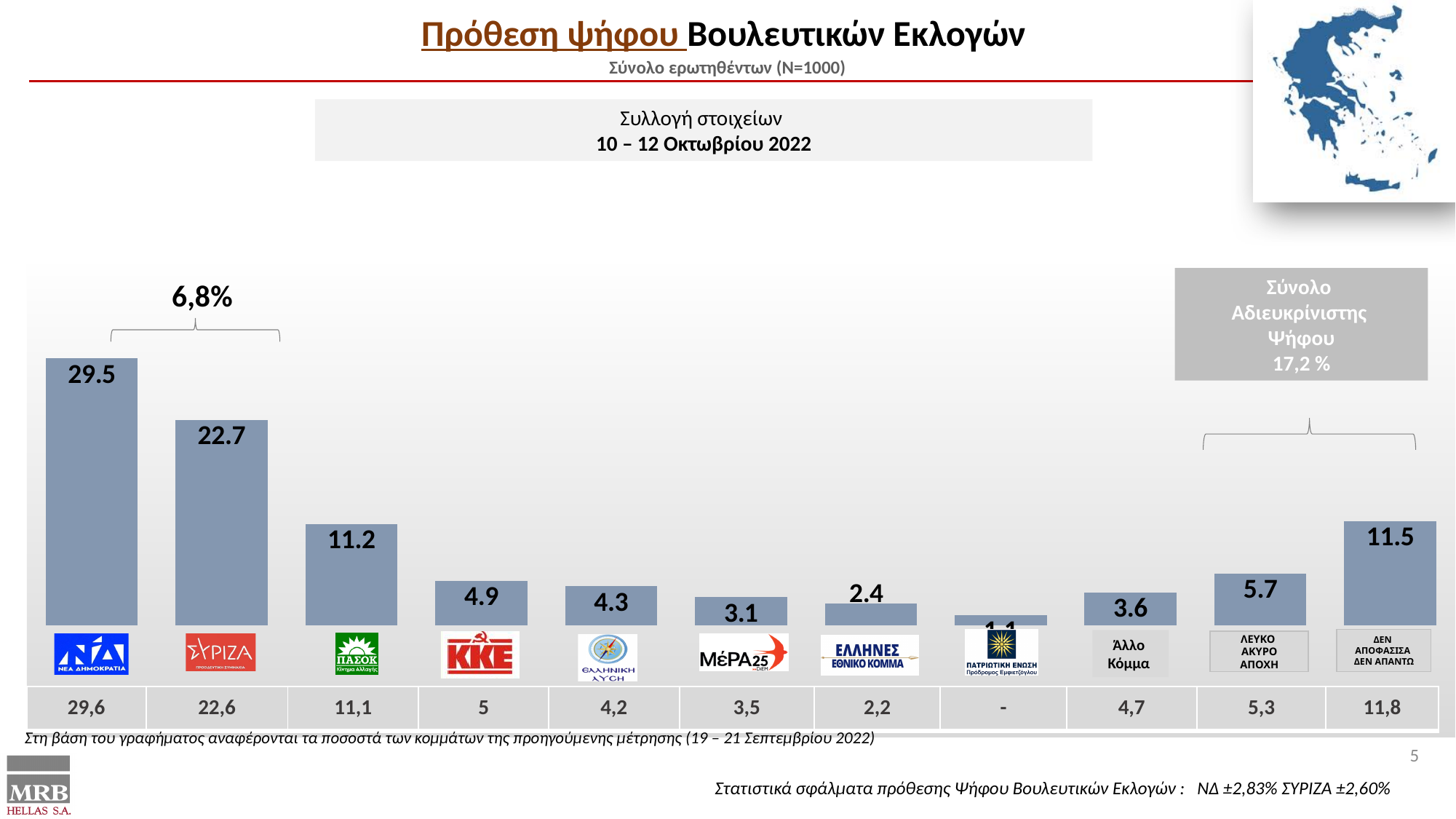
What kind of chart is shown on the slide? bar chart Which category has the highest value? ΝΕΑ ΔΗΜΟΚΡΑΤΙΑ What is the difference between the values for ΠΑΣΟΚ and ΚΚΕ? 6.3 What is the value shown for ΝΕΑ ΔΗΜΟΚΡΑΤΙΑ? 29.5 What is the value shown for ΔΕΝ ΑΠΟΦΑΣΙΣΑ ΔΕΝ ΑΠΑΝΤΩ? 11.5 What is the value shown for ΠΑΣΟΚ? 11.2 What is the value shown for ΚΚΕ? 4.9 How many bars are shown in the chart? 11 What is the difference between the values for ΝΕΑ ΔΗΜΟΚΡΑΤΙΑ and ΣΥΡΙΖΑ, as labelled on the chart? 6,8% What is the value shown for ΣΥΡΙΖΑ? 22.7 What percentage is given in the grey box for Σύνολο Αδιευκρίνιστης Ψήφου? 17,2 % Which is larger, the value for ΚΚΕ or the value for ΕΛΛΗΝΙΚΗ ΛΥΣΗ? ΚΚΕ